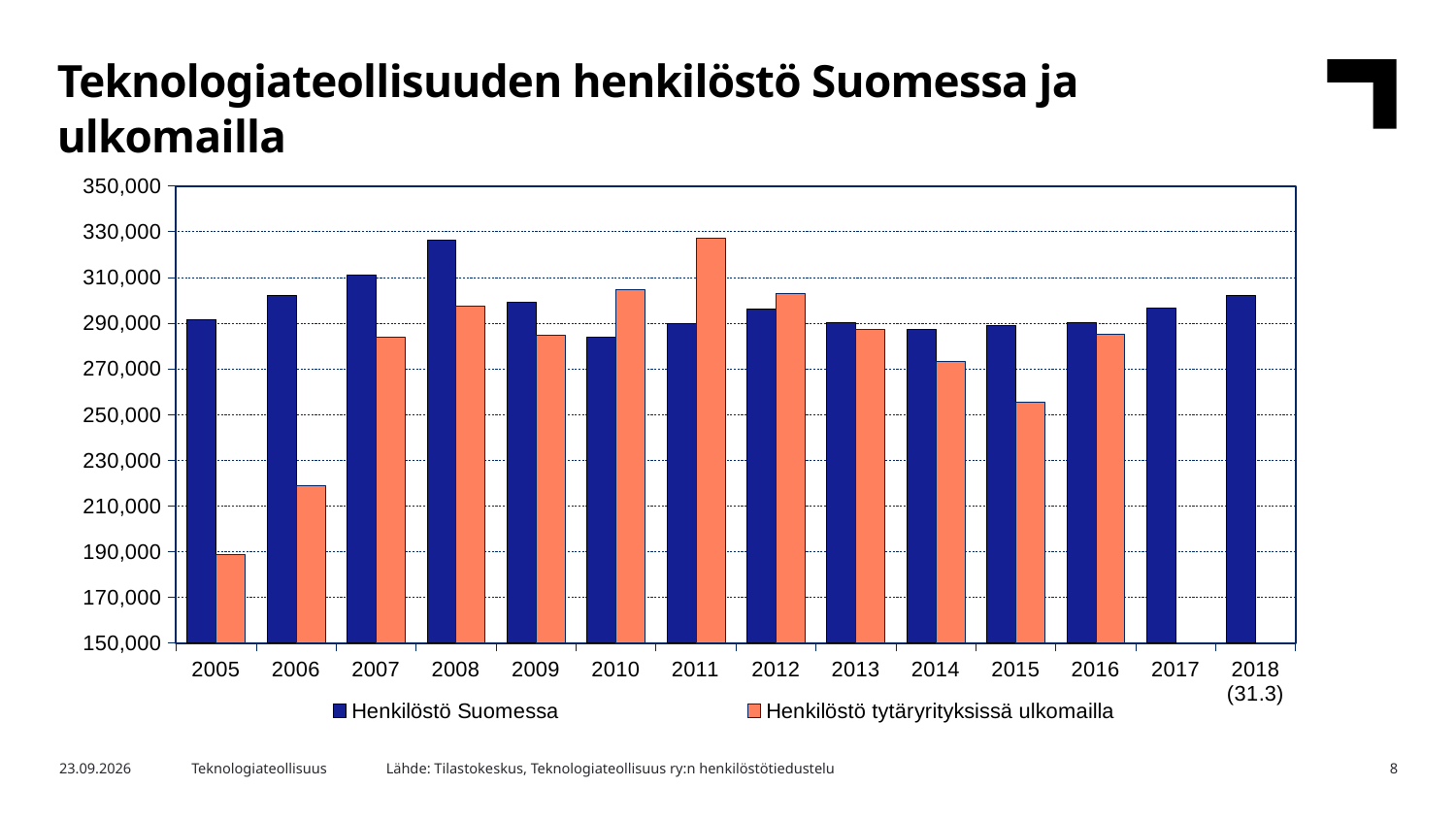
Is the value for Henkilöstö tytäryrityksissä ulkomailla in 2006 greater or less than 230,000? less In 2005, which series has the larger value, Henkilöstö Suomessa or Henkilöstö tytäryrityksissä ulkomailla? Henkilöstö Suomessa How many years are shown on the x axis? 14 In which year is Henkilöstö tytäryrityksissä ulkomailla lowest? 2005 How many series does the legend list? 2 In 2011, which series has the larger value, Henkilöstö Suomessa or Henkilöstö tytäryrityksissä ulkomailla? Henkilöstö tytäryrityksissä ulkomailla What kind of chart is shown on the slide? bar chart Is the value for Henkilöstö tytäryrityksissä ulkomailla in 2015 greater or less than 270,000? less In which year is Henkilöstö tytäryrityksissä ulkomailla highest? 2011 Is the value for Henkilöstö Suomessa in 2008 greater or less than 310,000? greater In which year is Henkilöstö Suomessa highest? 2008 Does Henkilöstö tytäryrityksissä ulkomailla rise or fall from 2005 to 2008? rise